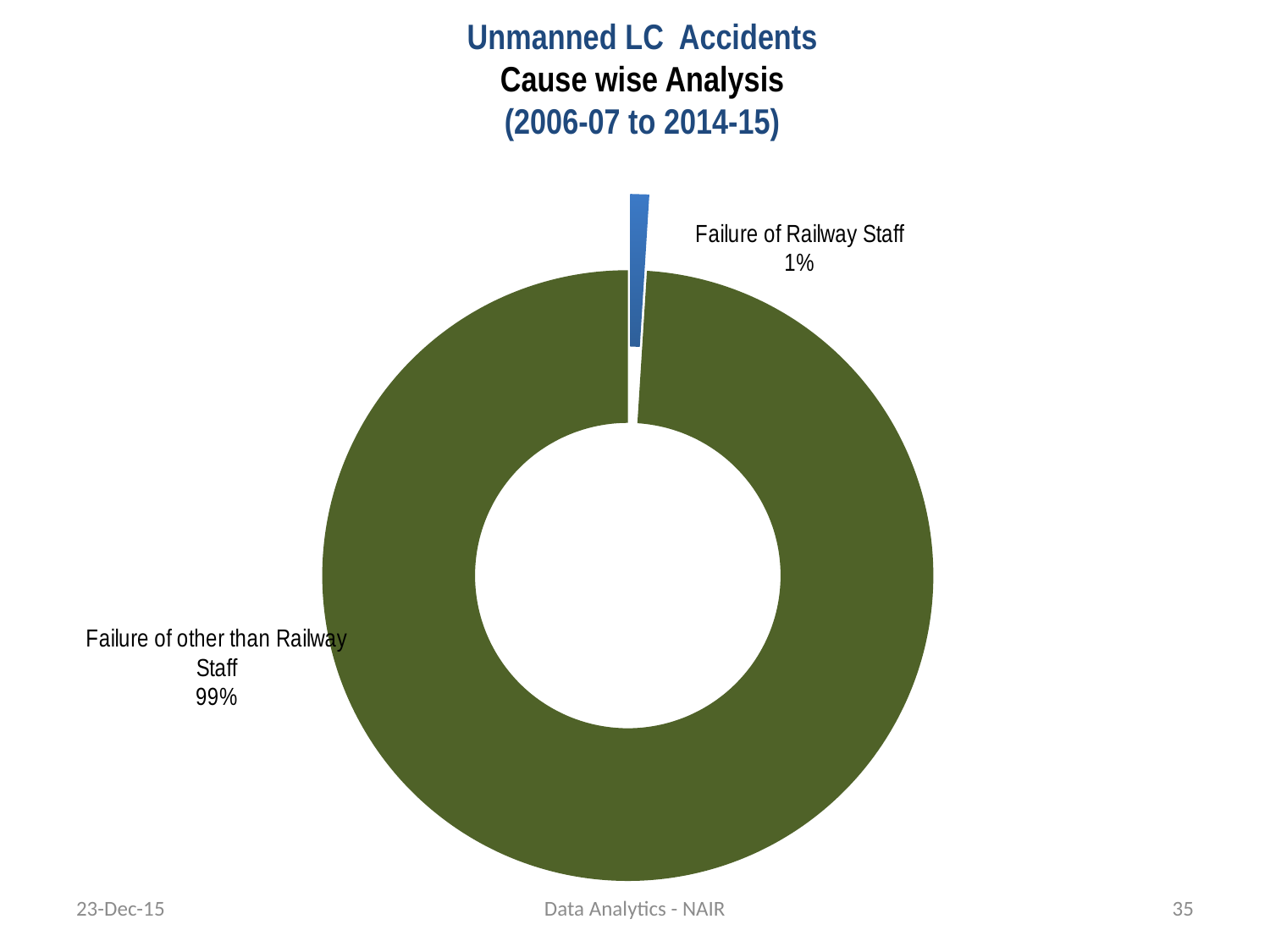
Which is larger: the share for Failure of Railway Staff or the share for Failure of other than Railway Staff? Failure of other than Railway Staff What share of unmanned LC accidents is attributed to Failure of other than Railway Staff? 99% What kind of chart is shown on the slide? Doughnut (pie) chart What period does the chart cover according to the title? 2006-07 to 2014-15 What is the combined share of the two slices shown in the chart? 100% How many categories are shown in the chart? 2 Which cause accounts for the smallest share of unmanned LC accidents? Failure of Railway Staff What colour is the slice for Failure of Railway Staff? Blue What share of unmanned LC accidents is attributed to Failure of Railway Staff? 1% What is the difference in percentage points between the share for Failure of other than Railway Staff and Failure of Railway Staff? 98 percentage points Which cause accounts for the largest share of unmanned LC accidents? Failure of other than Railway Staff